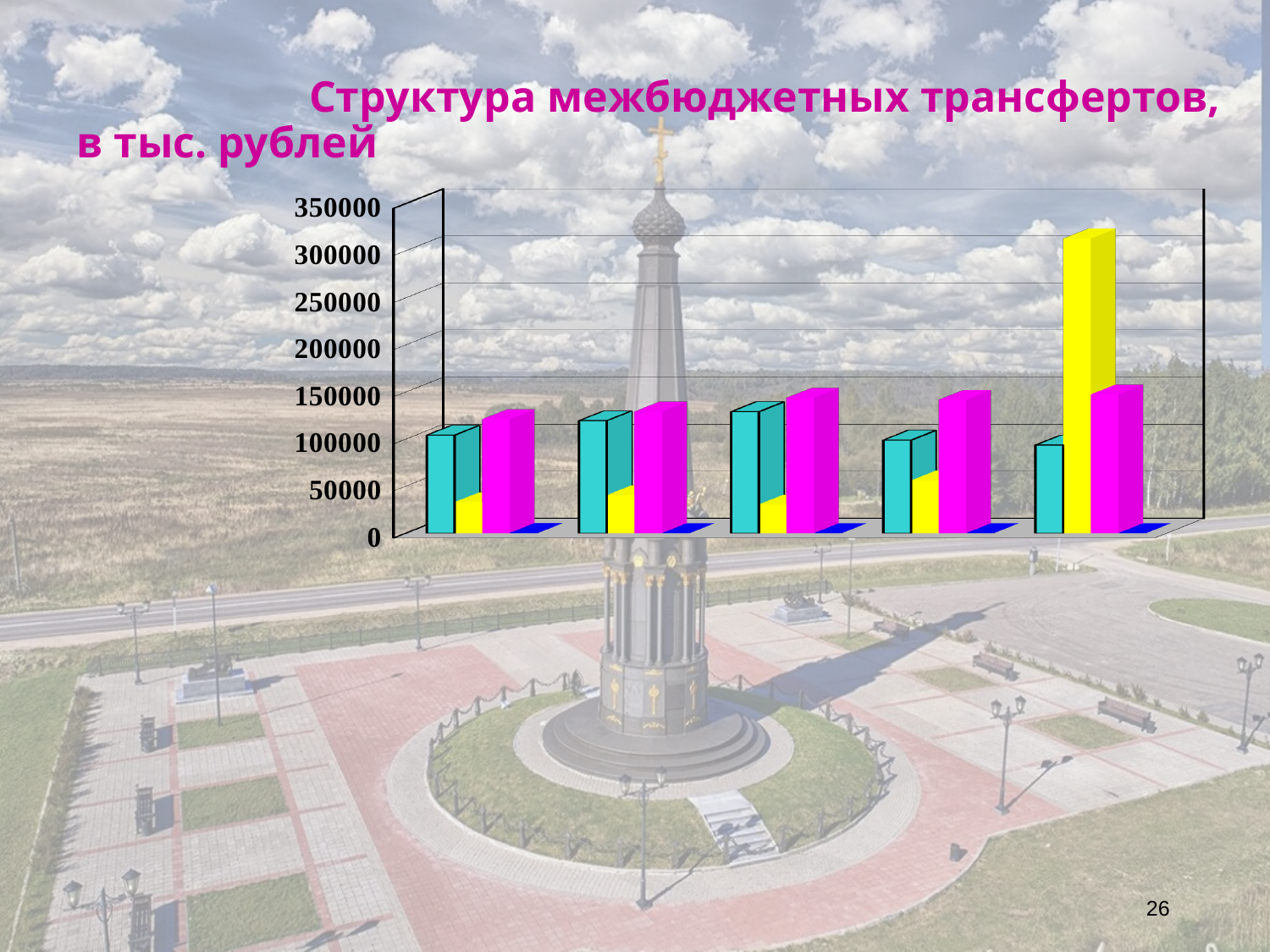
What is the title of the chart? Структура межбюджетных трансфертов, в тыс. рублей Is the value of the yellow bar in the rightmost group greater or less than 300000? greater Is the value of the yellow bar in the first (leftmost) group greater or less than 50000? less How many groups of bars are plotted along the x axis? 5 What is the highest value shown on the vertical axis? 350000 In the leftmost group, which bar is taller: the cyan bar or the magenta bar? the magenta bar Is the value of the cyan bar in the third group from the left greater or less than 100000? greater Which group of bars, counting from the left, contains the tallest bar in the chart? the fifth (rightmost) group In the rightmost group, which bar is taller: the yellow bar or the magenta bar? the yellow bar What kind of chart is shown on the slide? bar chart What colour is the tallest bar in the chart? yellow